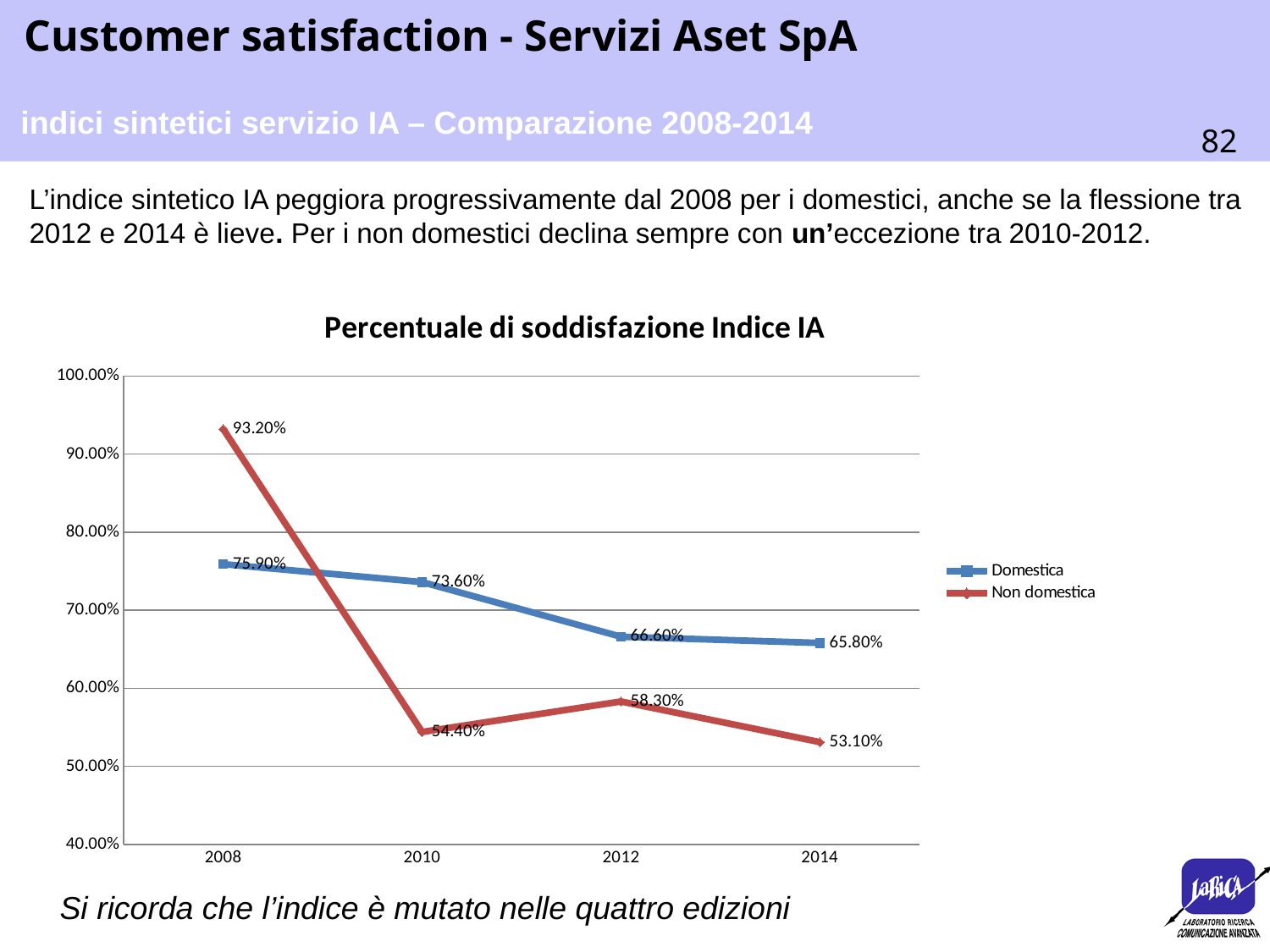
What is the value for Non domestica in 2010? 54.40% In which year is the Non domestica series highest? 2008 Does the Domestica series rise or fall from 2008 to 2014? Fall How many series does the legend list? 2 How many years are shown on the x axis? 4 What is the value for Domestica in 2008? 75.90% What is the difference between the Non domestica values in 2008 and 2010? 38.80% In which year is the Domestica series lowest? 2014 What kind of chart is shown on the slide? Line chart What is the value for Non domestica in 2014? 53.10% What is the value for Domestica in 2012? 66.60% Which series has the larger value in 2012, Domestica or Non domestica? Domestica